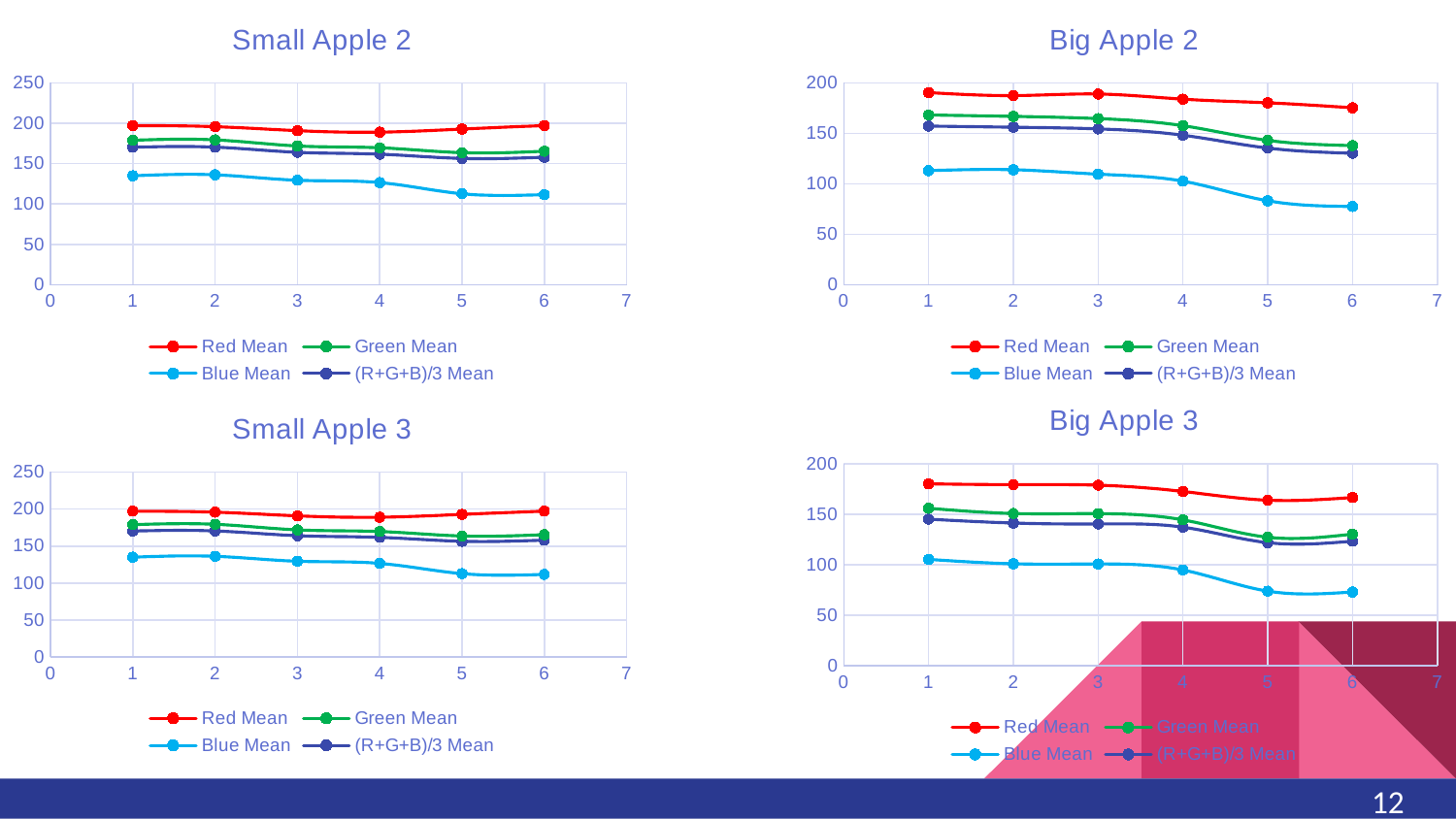
In 'Big Apple 3', which series has the highest values across all points? Red Mean How many data points does the Red Mean series have in 'Small Apple 3'? 6 In 'Big Apple 3', is the Red Mean value at x=5 greater or less than 150? greater In 'Small Apple 2', is the Red Mean value at x=1 greater or less than 150? greater In 'Big Apple 2', does the Blue Mean series rise or fall from x=1 to x=6? fall What is the highest value shown on the y axis of 'Small Apple 2'? 250 In 'Small Apple 3', which series has the lowest values across all points? Blue Mean How many series does the legend of 'Big Apple 2' list? 4 What kind of chart is 'Small Apple 2'? line chart In 'Big Apple 3', at x=1, which is larger: Green Mean or Blue Mean? Green Mean In 'Big Apple 2', is the Blue Mean value at x=6 greater or less than 100? less What is the title of the chart in the top-right of the slide? Big Apple 2